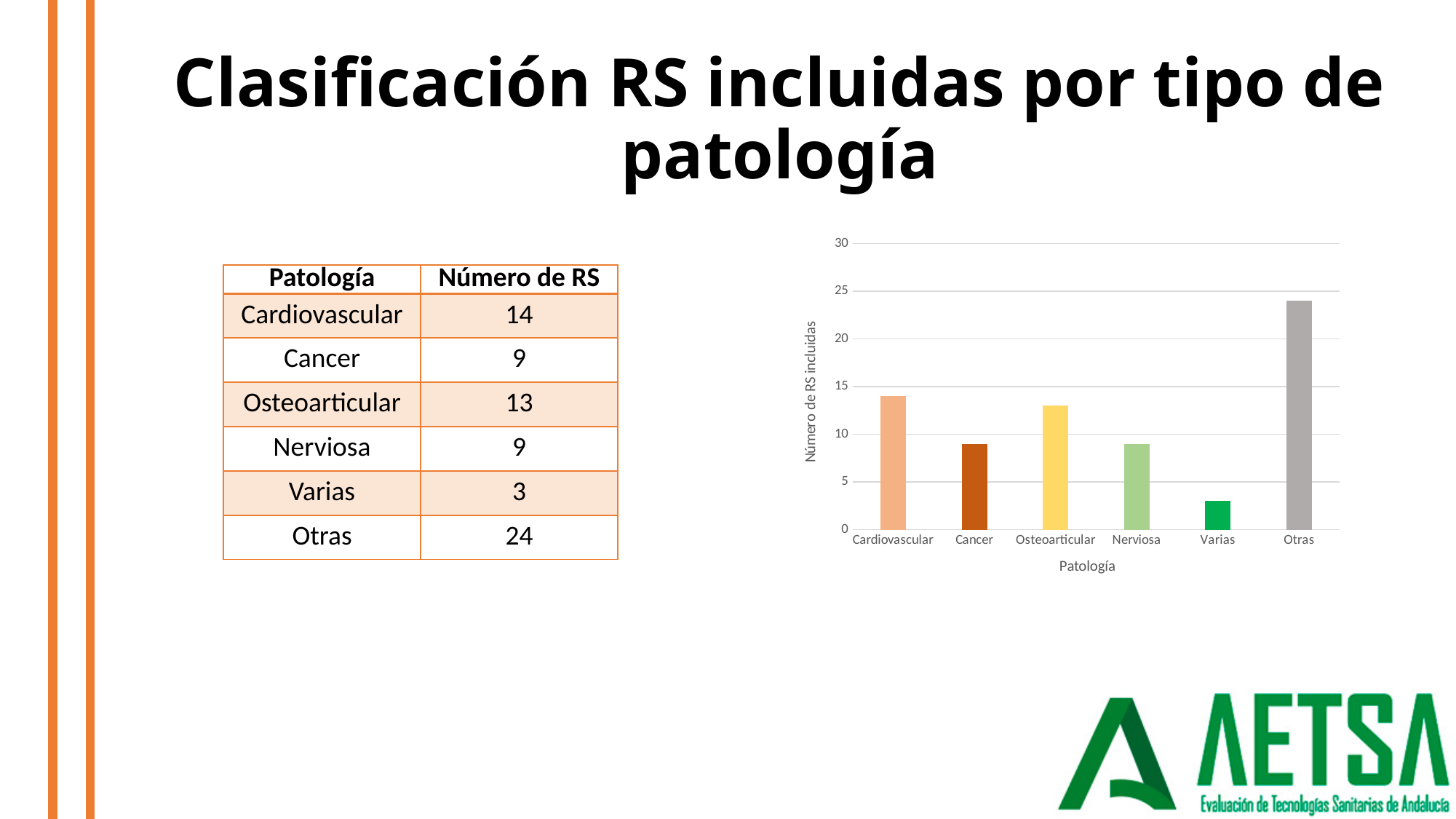
What is the number of RS included for Osteoarticular? 13 What is the difference between the number of RS for Otras and for Cardiovascular? 10 Which has more RS included, Cardiovascular or Cancer? Cardiovascular How many pathology categories are plotted in the bar chart? 6 What type of chart is shown on the slide? bar chart What is the number of RS included for Otras? 24 Which pathology category has the lowest number of RS included? Varias Which pathology category has the highest number of RS included? Otras What is the label of the horizontal axis of the chart? Patología What is the number of RS included for Cardiovascular? 14 What is the label of the vertical axis of the chart? Número de RS incluidas Is the value for Otras greater or less than 20? greater